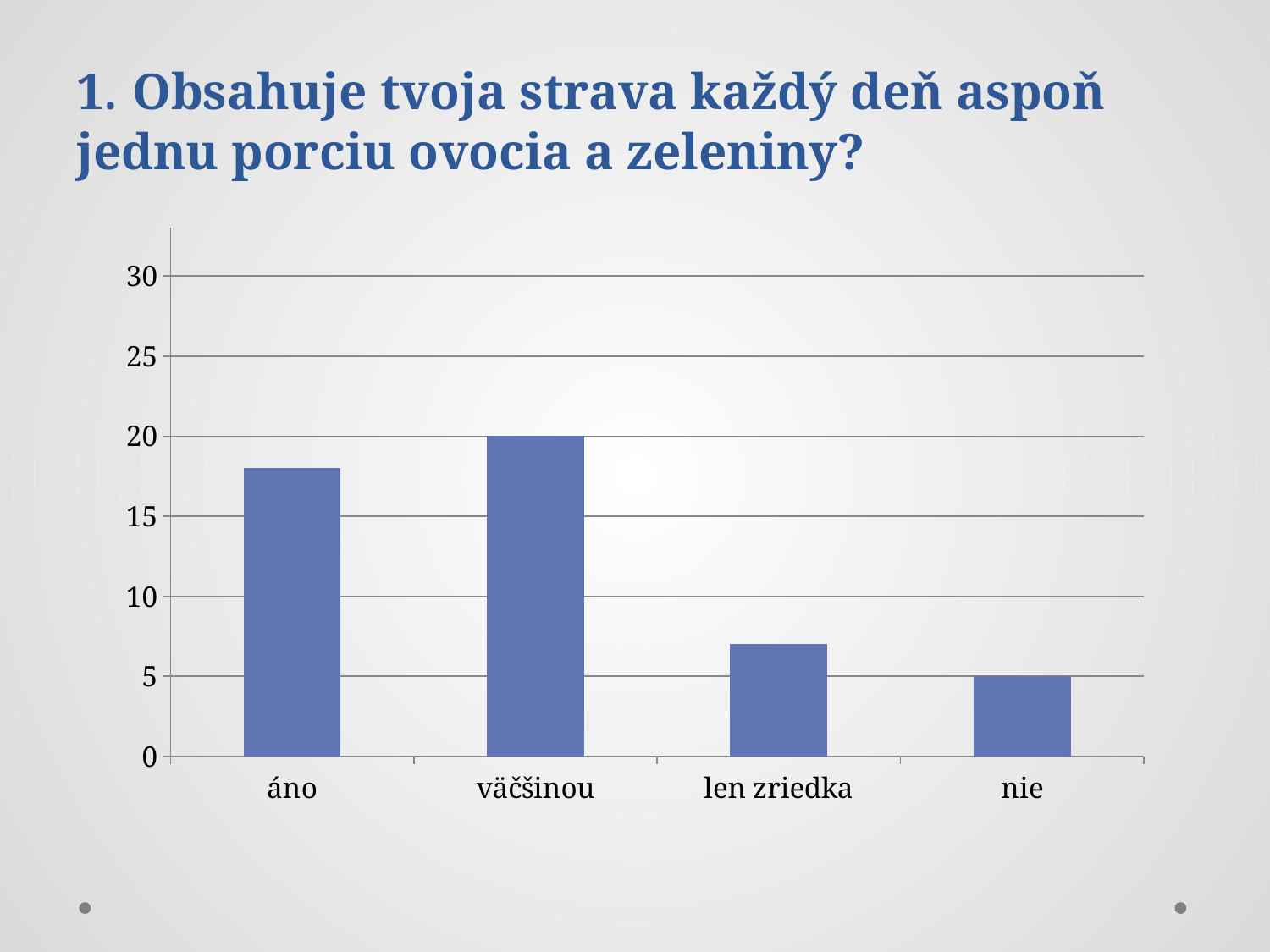
Is the value for len zriedka greater or less than 10? less What is the difference between the value for väčšinou and the value for nie? 15 Is the value for áno greater or less than 15? greater Which is larger, the value for len zriedka or the value for nie? len zriedka Which is larger, the value for áno or the value for väčšinou? väčšinou What is the title of the slide? 1. Obsahuje tvoja strava každý deň aspoň jednu porciu ovocia a zeleniny? Which category has the lowest value? nie What is the value for nie? 5 Which category has the highest value? väčšinou What kind of chart is shown on the slide? bar chart How many categories are shown on the x axis? 4 What is the value for väčšinou? 20